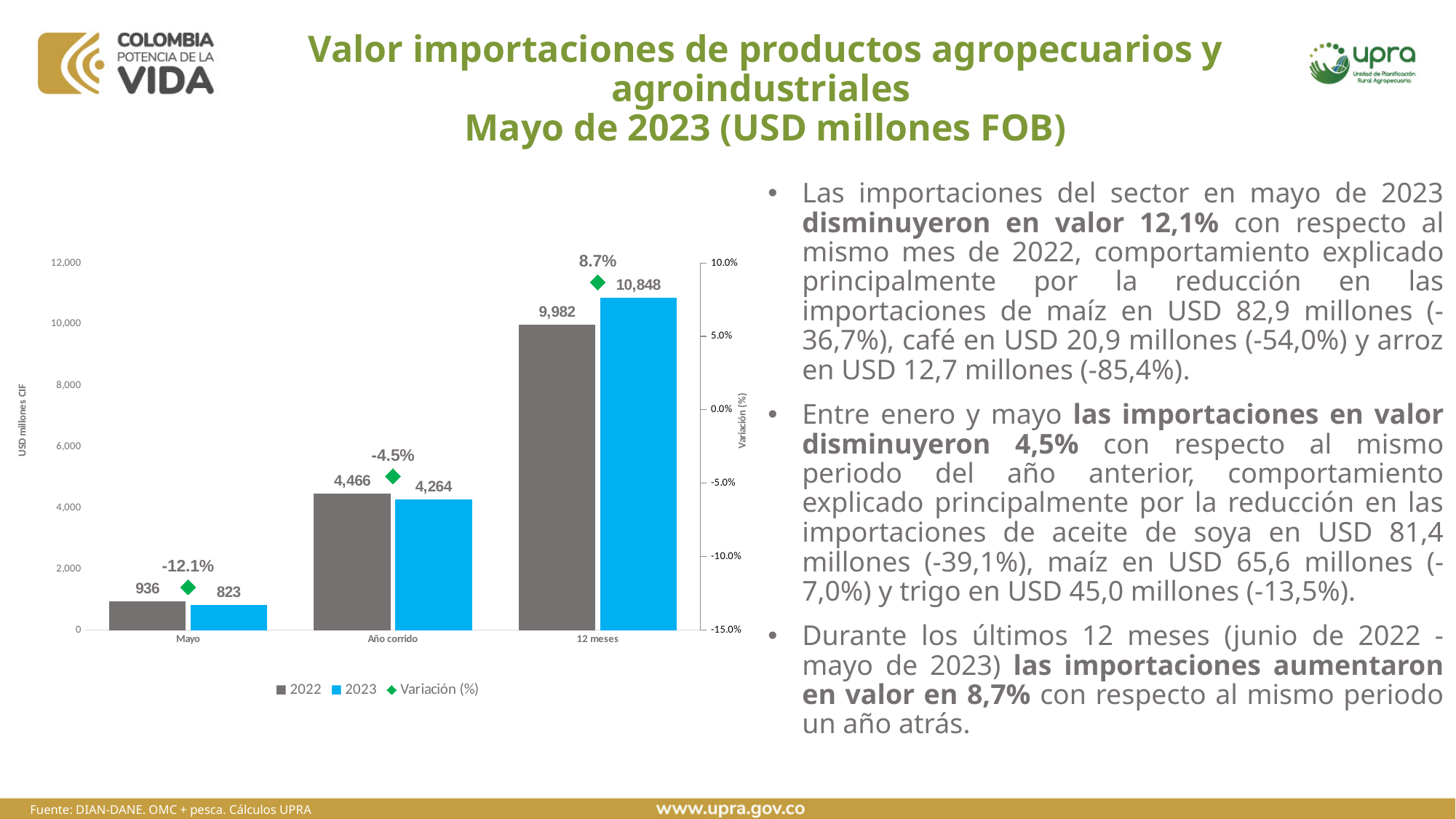
Which is larger for Año corrido, the 2022 value or the 2023 value? 2022 What is the 2022 value for Mayo? 936 Which category has the lowest 2022 value? Mayo What is the 2023 value for Año corrido? 4,264 What kind of chart is shown on the slide? Bar chart What is the Variación (%) value for Mayo? -12.1% Which category has the highest 2023 value? 12 meses What is the difference between the 2022 and 2023 values for 12 meses? 866 What is the label of the left vertical axis? USD millones CIF What is the Variación (%) value for 12 meses? 8.7% How many categories are shown on the x axis? 3 How many series does the legend list? 3